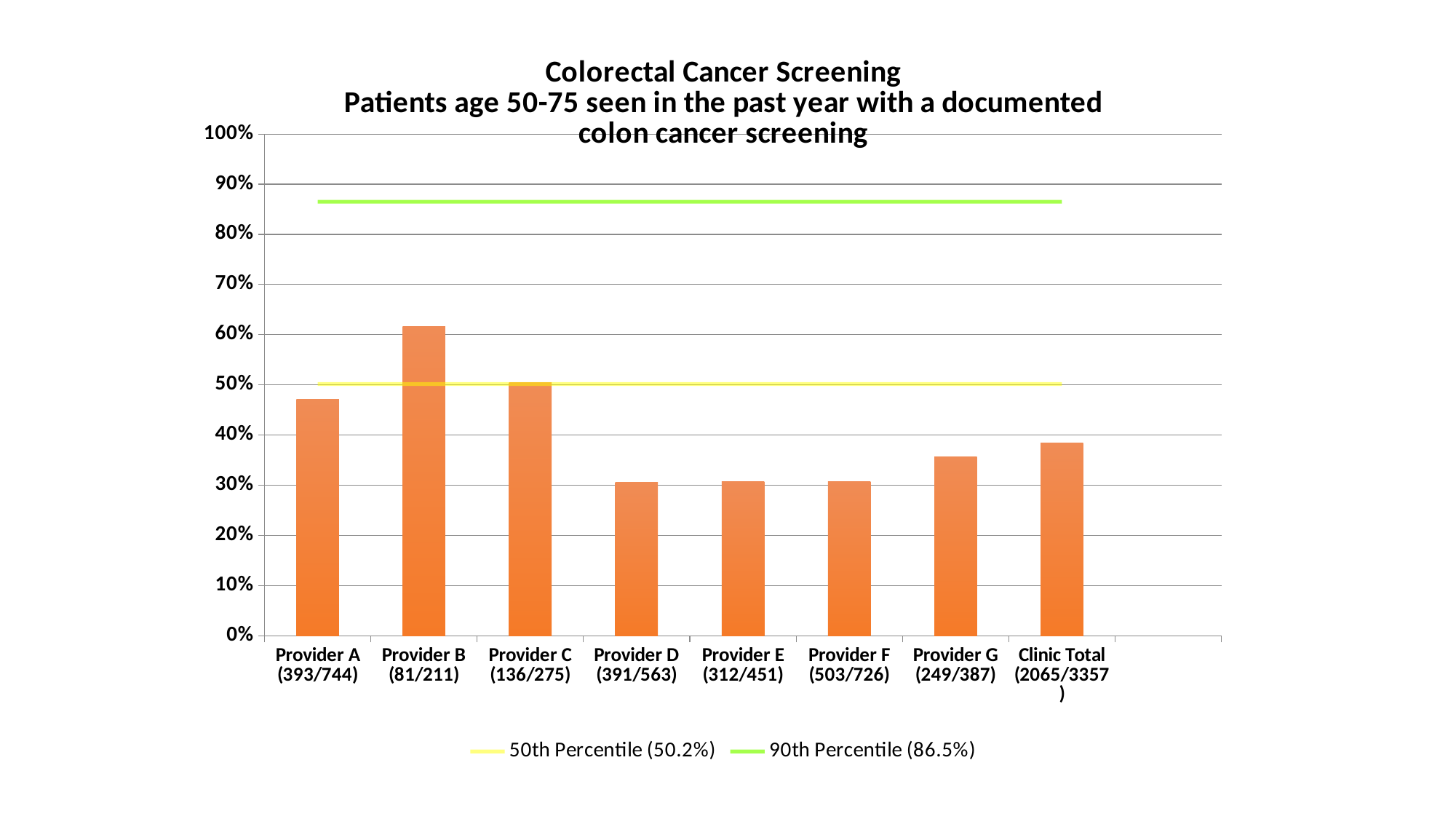
How many entries does the legend list? 2 What kind of chart is shown on the slide? bar chart Is the value for Provider A greater or less than 50%? less Which is larger, the value for Clinic Total or the value for Provider G? Clinic Total Is the value for Provider D greater or less than 40%? less How many categories are plotted along the x axis? 8 What value does the legend give for the 90th Percentile line? 86.5% Which is larger, the value for Provider B or the value for Provider G? Provider B What fraction is shown in the axis label for Clinic Total? 2065/3357 Is the value for Provider B greater or less than 60%? greater What value does the legend give for the 50th Percentile line? 50.2% Which provider has the highest screening rate? Provider B